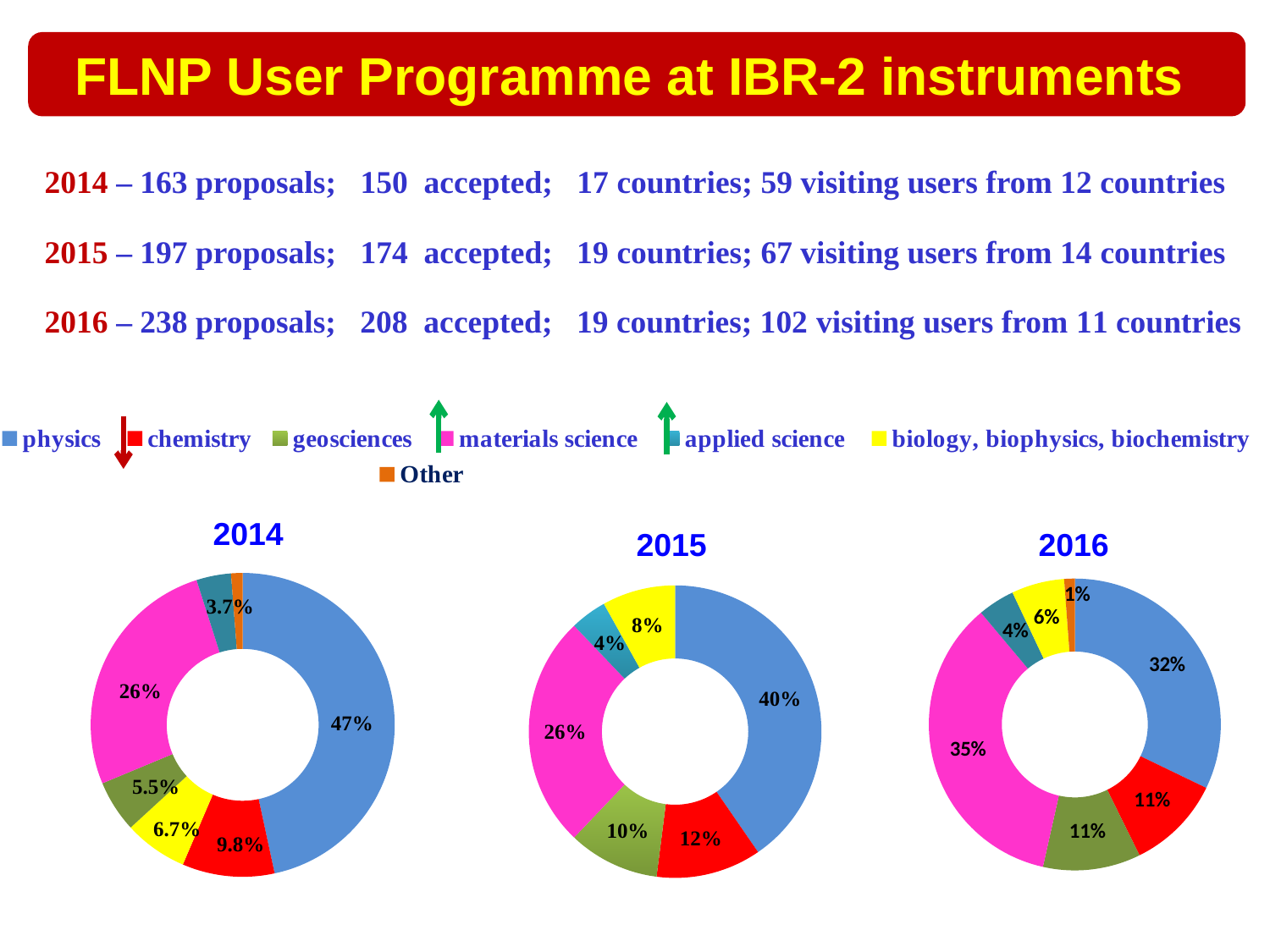
In the 2016 chart, what share does materials science have? 35% In the 2016 chart, which category has the smallest share? Other In the 2015 chart, what share does materials science have? 26% In the 2014 chart, what share does physics have? 47% In the 2014 chart, which is larger, the chemistry share or the geosciences share? chemistry What kind of chart is used for the 2015 data? doughnut chart In the 2016 chart, which category has the largest share? materials science In the 2015 chart, which category has the smallest share? applied science In the 2014 chart, what share does applied science have? 3.7% In the 2015 chart, what is the difference between the physics share and the materials science share? 14% Which colour represents materials science in the charts? magenta How many categories does the legend list? 7